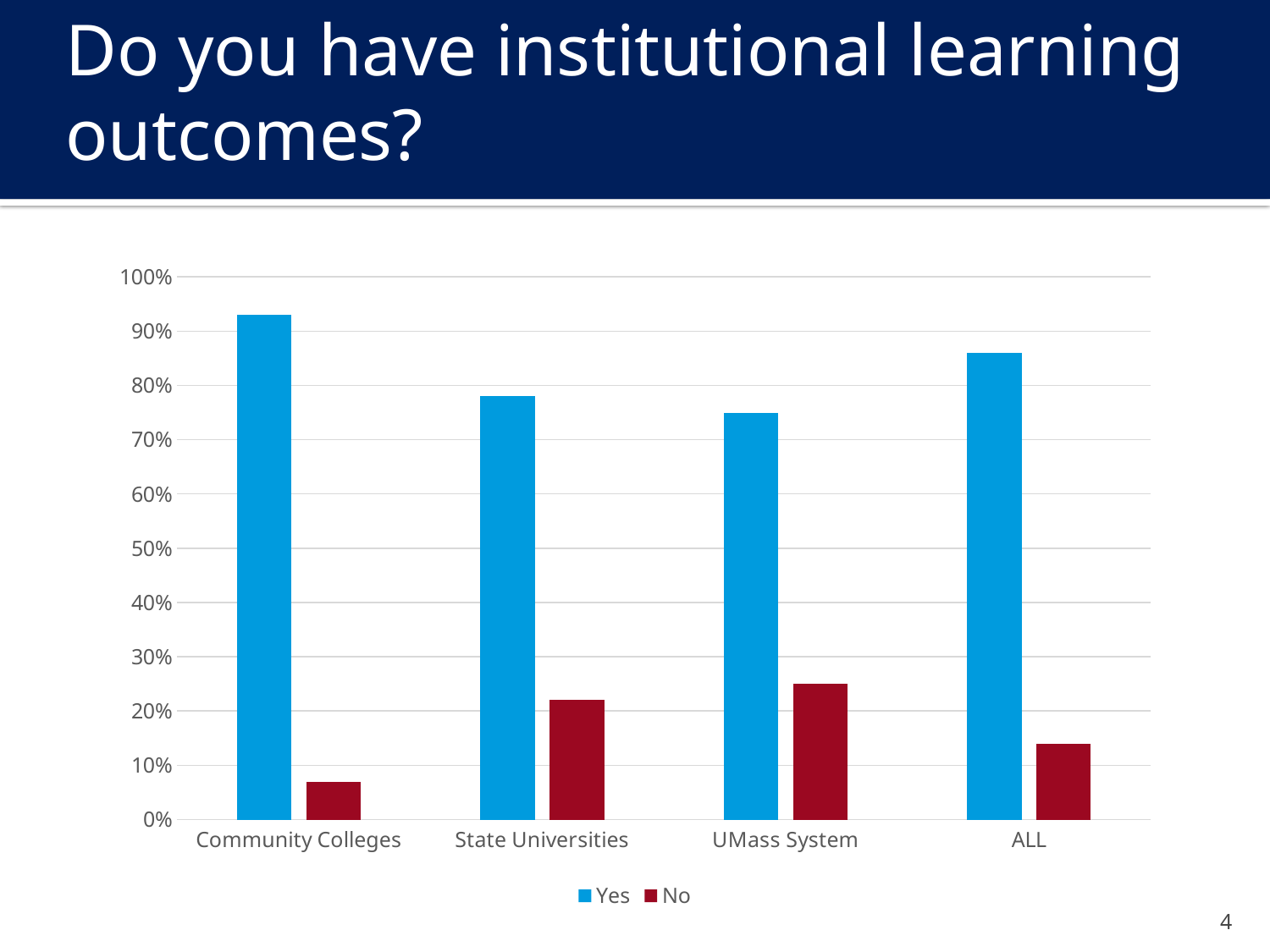
Which category has the lowest No value? Community Colleges How many series does the legend list? 2 What colour are the bars for the No series? dark red Which category has the lowest Yes value? UMass System Which category has the highest Yes value? Community Colleges How many categories are shown along the x axis? 4 Is the Yes value for ALL greater or less than 80%? greater Is the No value for UMass System greater or less than 20%? greater Which category has the highest No value? UMass System What kind of chart is shown on the slide? bar chart Is the Yes value for Community Colleges greater or less than 90%? greater Which is larger, the Yes value for State Universities or the Yes value for ALL? ALL